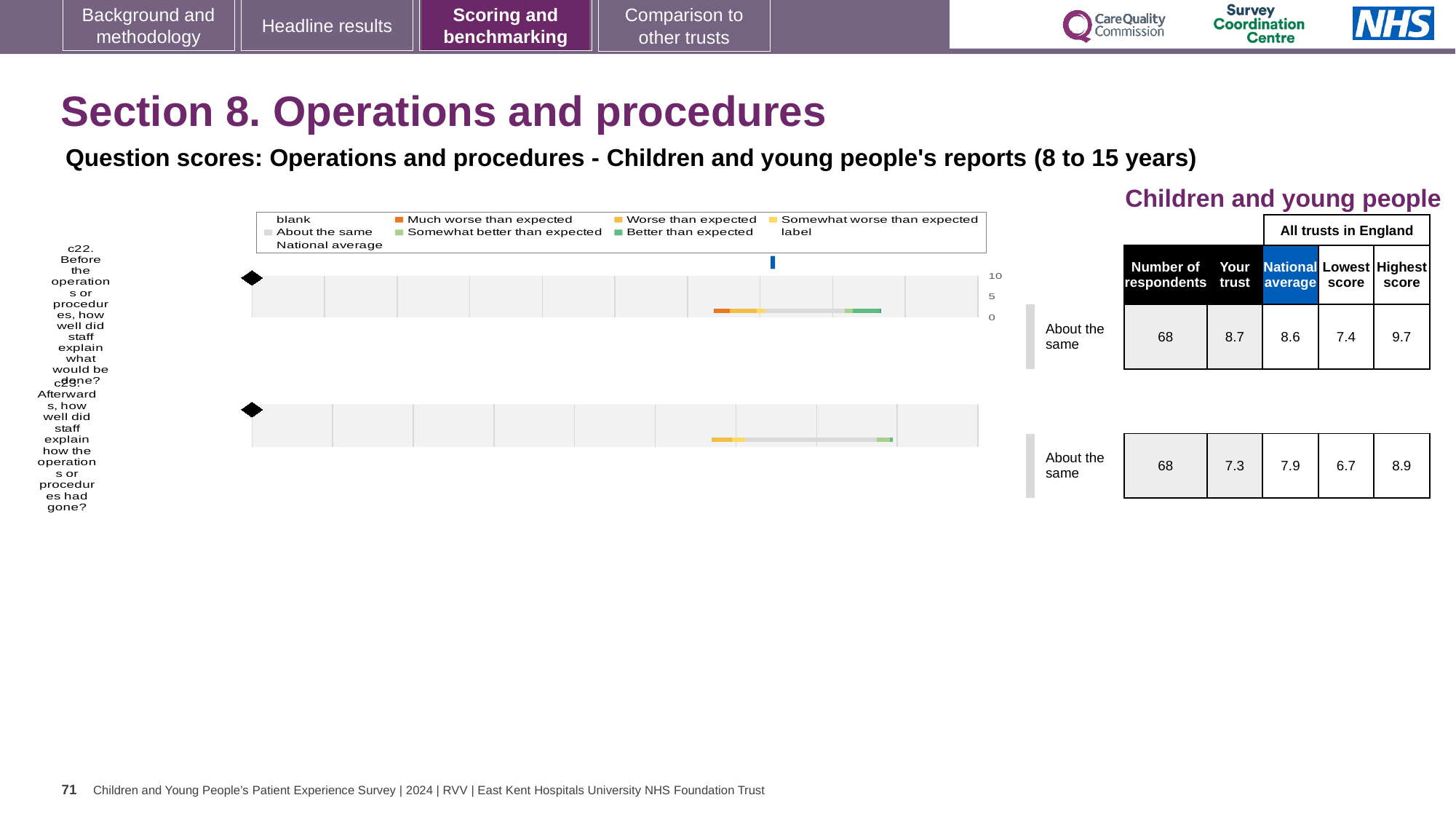
What is the lowest score across all trusts in England for question c23? 6.7 For question c22, what is the national average score shown in the table? 8.6 How many respondents answered question c22? 68 For question c23, what is the national average score shown in the table? 7.9 For question c23 (Afterwards, how well did staff explain how the operations or procedures had gone?), what is the 'Your trust' score shown in the table? 7.3 For question c22 (Before the operations or procedures, how well did staff explain what would be done?), what is the 'Your trust' score shown in the table? 8.7 For question c23, is the 'Your trust' score higher or lower than the national average? lower What benchmarking category is shown for both question c22 and question c23? About the same For question c22, what is the difference between the highest score (9.7) and the lowest score (7.4) across all trusts in England? 2.3 What is the highest score across all trusts in England for question c22? 9.7 What kind of chart is used to show the benchmarking results for questions c22 and c23? bar chart How many questions (c22 and c23) are plotted as benchmarking bars on the slide? 2